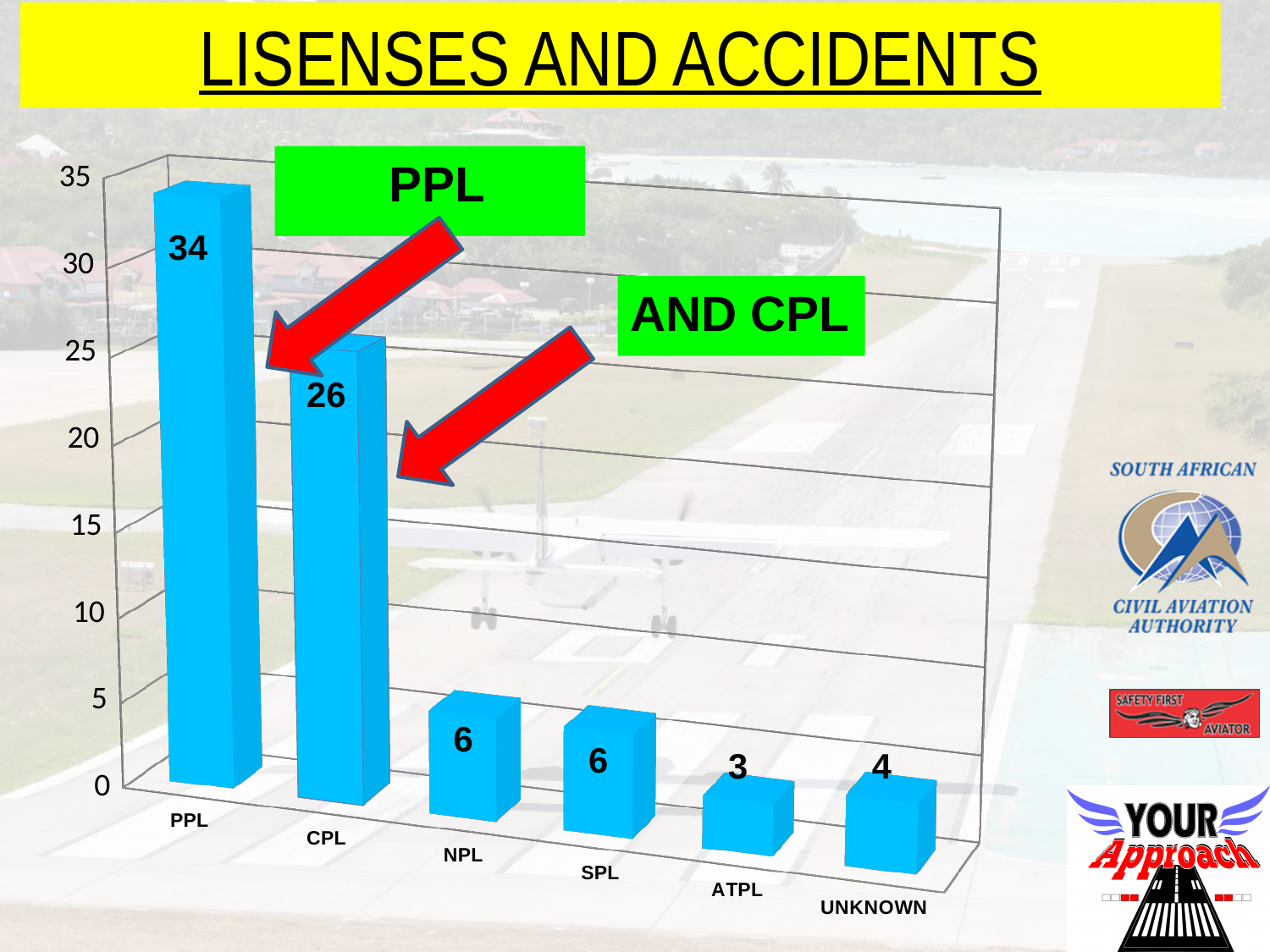
How many categories are shown on the x axis? 6 What is the value for UNKNOWN? 4 What is the difference between the values for PPL and CPL? 8 What is the title of the slide? LISENSES AND ACCIDENTS Which is larger, the value for UNKNOWN or the value for ATPL? UNKNOWN What is the value for PPL? 34 What kind of chart is shown on the slide? bar chart What is the value for ATPL? 3 Which category has the lowest value? ATPL What is the value for CPL? 26 Is the value for CPL greater or less than 25? greater Which category has the highest value? PPL